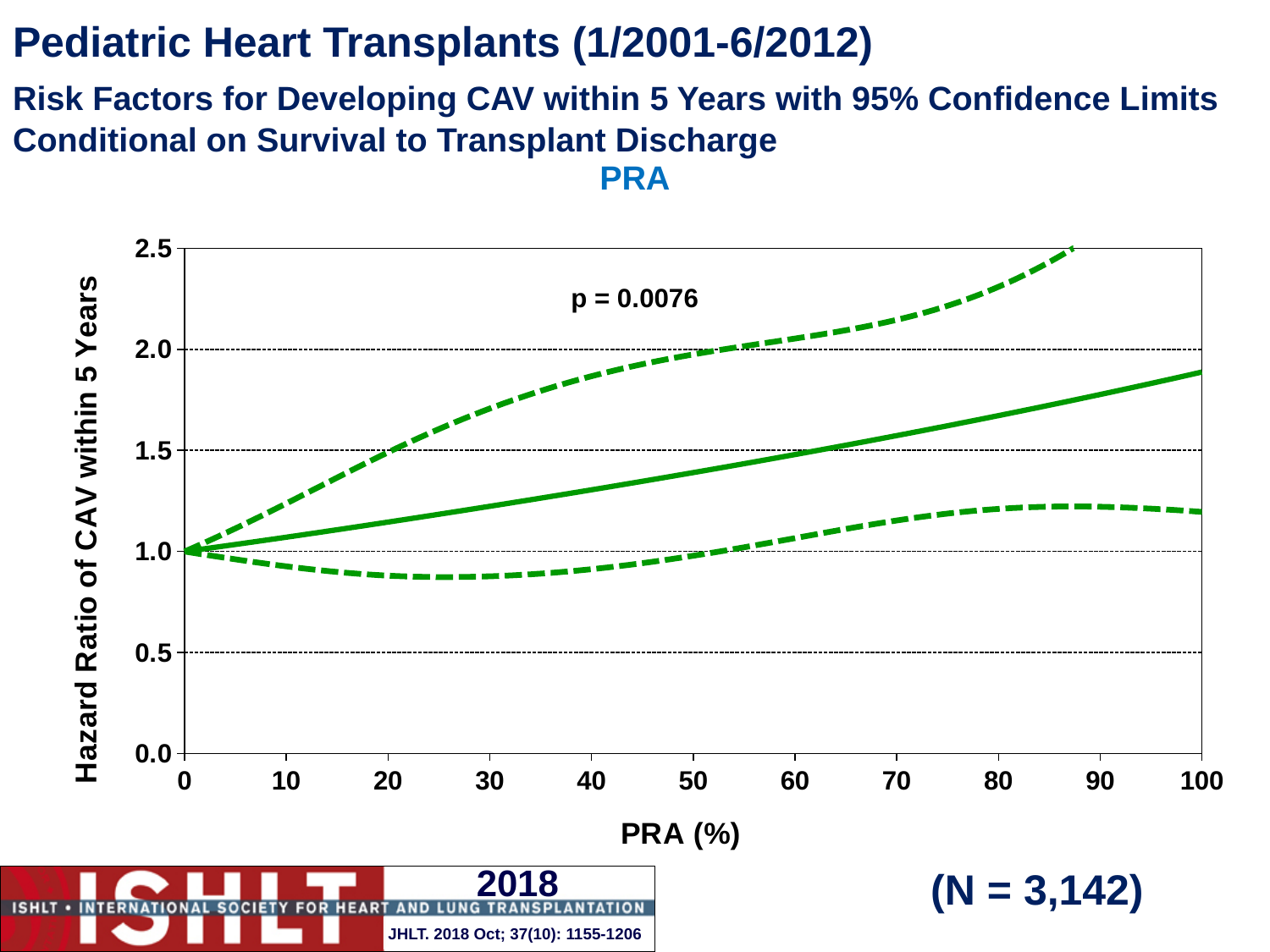
Does the solid hazard ratio line rise or fall as PRA (%) increases from 0 to 100? rise Is the lower dashed confidence limit at a PRA of 90% greater or less than 1.0? greater Is the solid hazard ratio line at a PRA of 100% greater or less than 2.0? less Is the solid hazard ratio line at a PRA of 50% greater or less than 1.5? less What p-value is printed on the chart? p = 0.0076 How many lines are plotted on the chart? 3 What kind of chart is shown on the slide? line chart What is the label of the x axis? PRA (%) What is the hazard ratio of CAV within 5 years at a PRA of 0%? 1.0